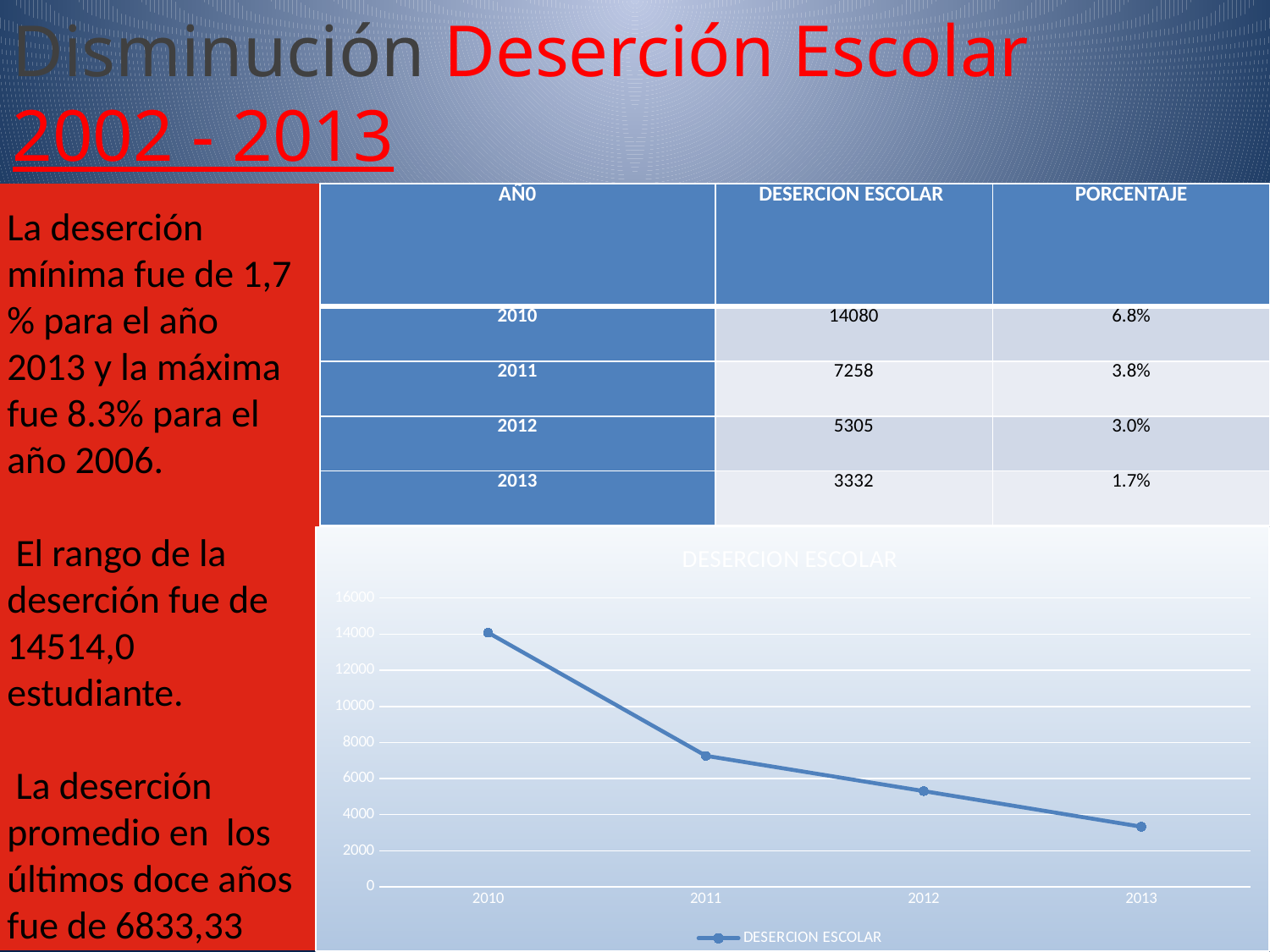
How many series does the chart legend list? 1 Is the value for 2011 in the chart greater or less than 8000? less Which year has the lowest value in the chart? 2013 Which year has the highest value in the chart? 2010 Which is larger in the chart, the value for 2011 or the value for 2012? 2011 Is the value for 2010 in the chart greater or less than 12000? greater What is the title of the chart? DESERCION ESCOLAR What kind of chart is shown on the slide? line chart Do the values in the chart rise or fall from 2010 to 2013? fall Is the value for 2013 in the chart greater or less than 4000? less How many years are plotted on the x axis of the chart? 4 According to the slide, what is the DESERCION ESCOLAR value for 2012? 5305